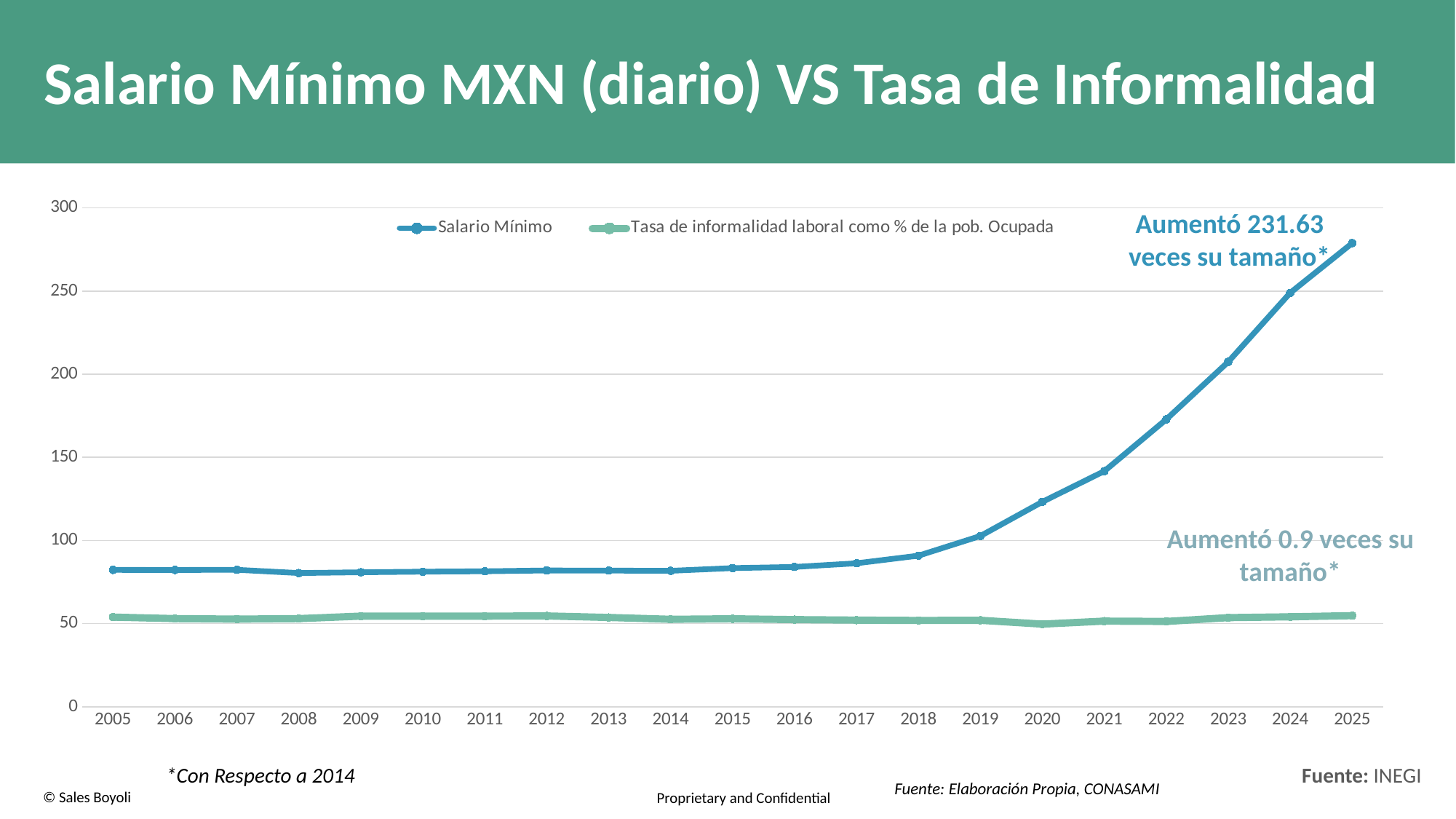
Which series is higher in 2015, Salario Mínimo or Tasa de informalidad laboral como % de la pob. Ocupada? Salario Mínimo Is the Salario Mínimo value for 2025 greater or less than 250? greater How many years are plotted along the x axis? 21 What is the title of the chart? Salario Mínimo MXN (diario) VS Tasa de Informalidad Is the Salario Mínimo value for 2021 greater or less than 150? less How many series does the legend list? 2 In which year is the Salario Mínimo series at its highest? 2025 What is the first year shown on the x axis? 2005 What kind of chart is shown on the slide? Line chart Is the Salario Mínimo value for 2005 greater or less than 100? less What is the last year shown on the x axis? 2025 Does the Salario Mínimo series rise or fall between 2018 and 2025? Rise